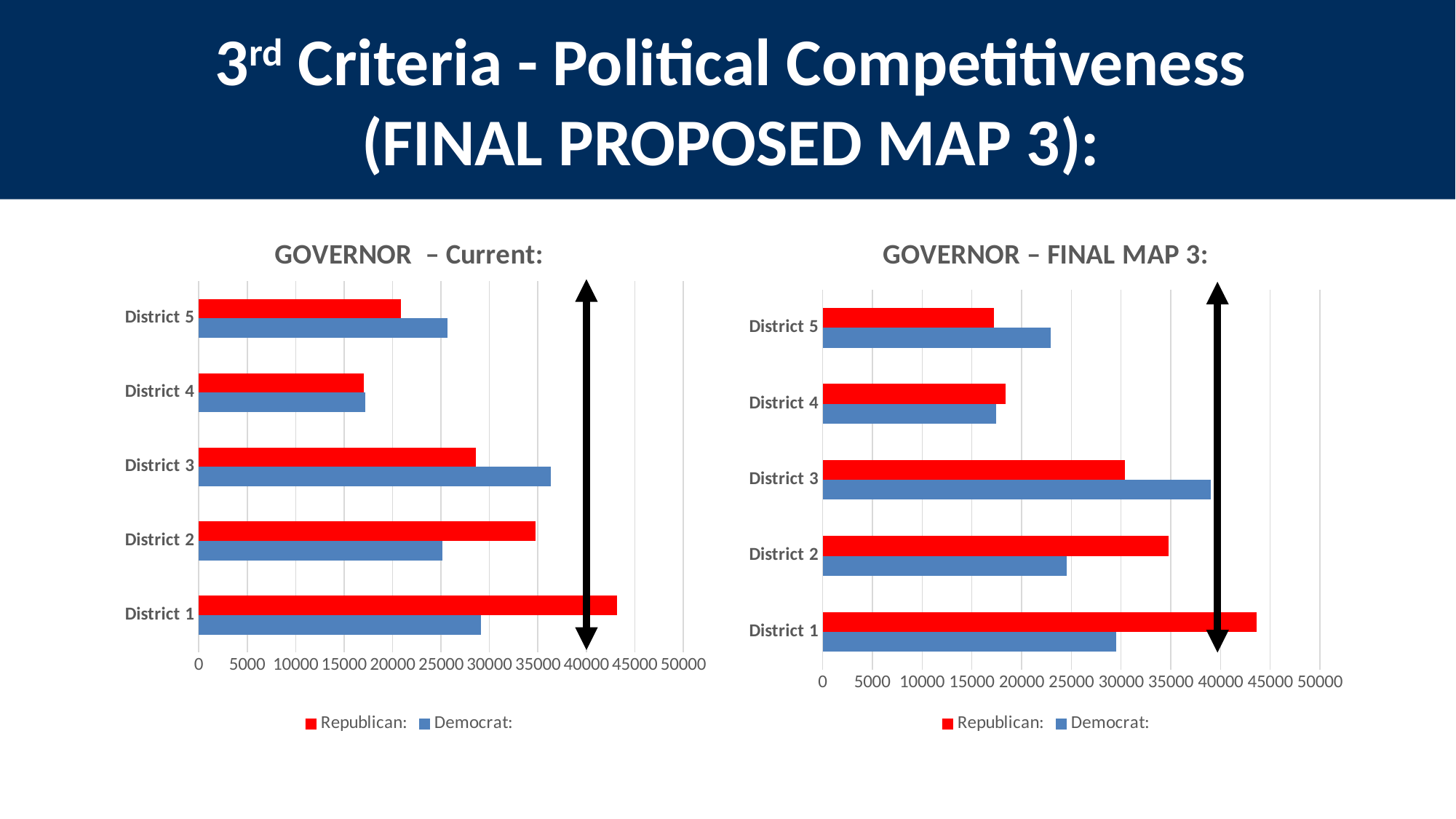
In the "GOVERNOR – FINAL MAP 3" chart, is the Republican value for District 5 greater or less than 20000? less How many series does the legend of the "GOVERNOR – Current" chart list? 2 What kind of chart is the "GOVERNOR – Current" chart on the left? Bar chart In the "GOVERNOR – FINAL MAP 3" chart, is the Democrat value for District 3 greater or less than 35000? greater In the "GOVERNOR – Current" chart, which district has the highest Republican value? District 1 What are the two legend entries in the "GOVERNOR – FINAL MAP 3" chart? Republican and Democrat In the "GOVERNOR – Current" chart, which district has the lowest Republican value? District 4 In the "GOVERNOR – Current" chart, is the Republican value for District 1 greater or less than 40000? greater How many districts are shown in the "GOVERNOR – FINAL MAP 3" chart? 5 In the "GOVERNOR – Current" chart, which is larger for District 3, the Republican or the Democrat value? Democrat In the "GOVERNOR – FINAL MAP 3" chart, which district has the highest Democrat value? District 3 In the "GOVERNOR – FINAL MAP 3" chart, which is larger for District 2, the Republican or the Democrat value? Republican